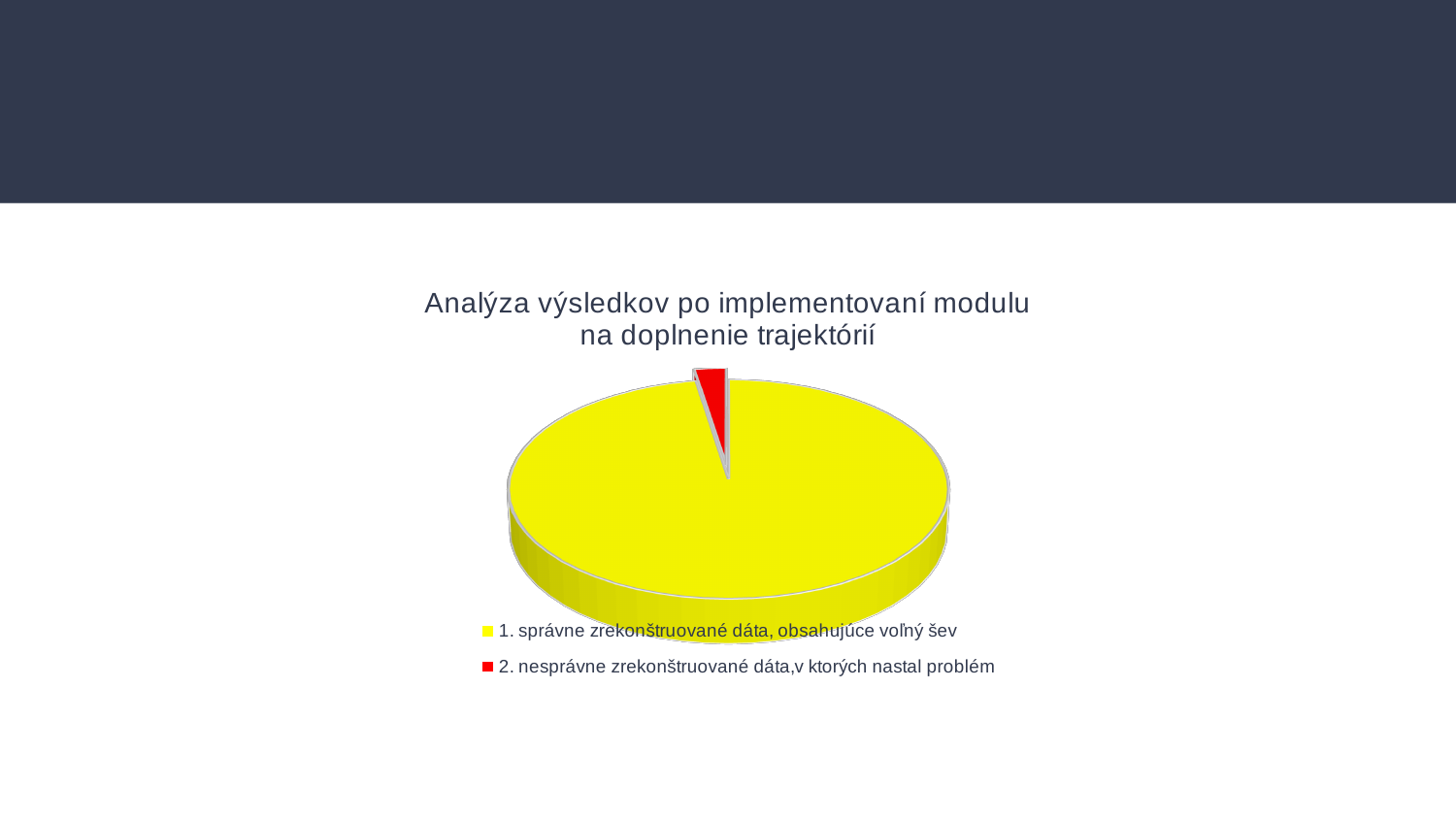
What is the title of the chart? Analýza výsledkov po implementovaní modulu na doplnenie trajektórií Which category has the smallest slice of the pie? 2. nesprávne zrekonštruované dáta,v ktorých nastal problém What colour is the slice for '2. nesprávne zrekonštruované dáta,v ktorých nastal problém'? red Which category has the largest slice of the pie? 1. správne zrekonštruované dáta, obsahujúce voľný šev How many slices does the pie chart have? 2 Which is larger: the slice for '1. správne zrekonštruované dáta, obsahujúce voľný šev' or the slice for '2. nesprávne zrekonštruované dáta,v ktorých nastal problém'? 1. správne zrekonštruované dáta, obsahujúce voľný šev How many entries does the legend list? 2 What kind of chart is shown on the slide? pie chart